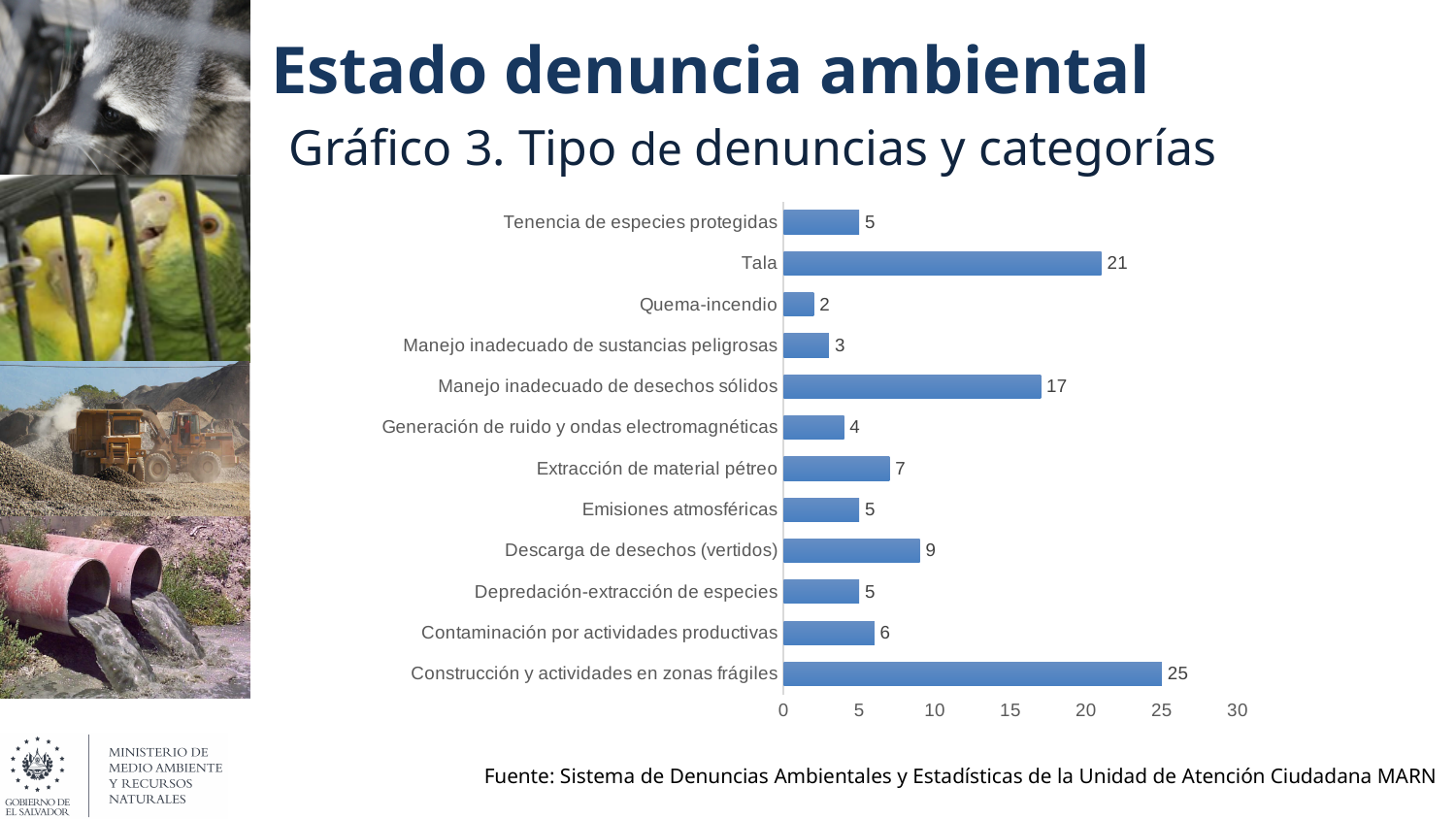
What is the difference between the values for Construcción y actividades en zonas frágiles and Tala? 4 Which category has the lowest value? Quema-incendio Which category has the highest value? Construcción y actividades en zonas frágiles How many categories are shown in the chart? 12 What is the value for Generación de ruido y ondas electromagnéticas? 4 What is the value for Descarga de desechos (vertidos)? 9 What is the value for Tala? 21 What is the title of the chart? Gráfico 3. Tipo de denuncias y categorías Is the value for Manejo inadecuado de desechos sólidos greater or less than 15? greater Which is larger, the value for Extracción de material pétreo or the value for Contaminación por actividades productivas? Extracción de material pétreo What kind of chart is shown on the slide? Bar chart What is the value for Manejo inadecuado de desechos sólidos? 17